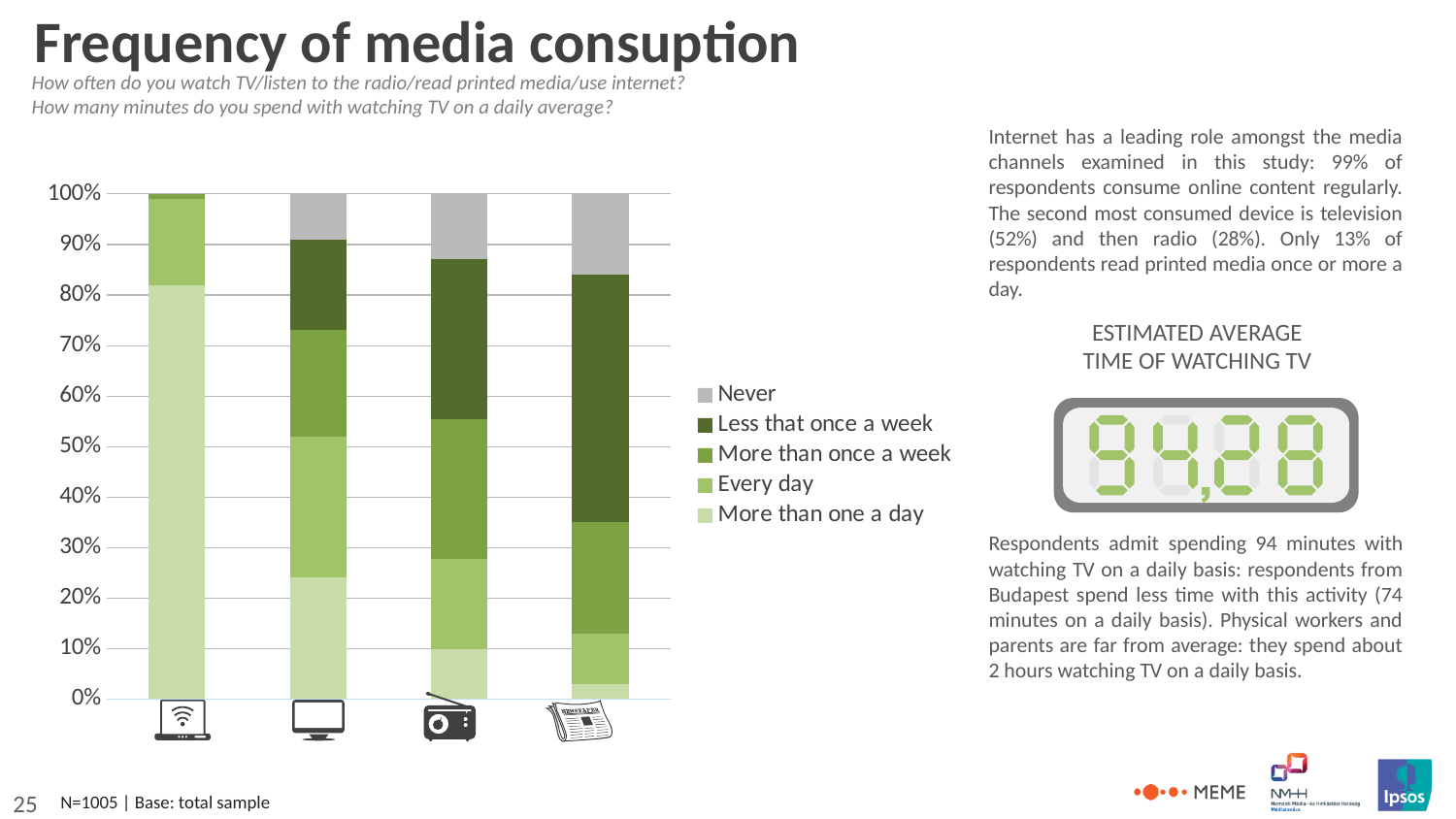
How many bars (media categories) are plotted in the chart? 4 What kind of chart is shown on the slide? Stacked bar chart Which entry is listed first in the chart's legend? Never Which bar has the larger 'Never' segment: the second bar (TV icon) or the fourth bar (newspaper icon)? The fourth bar (newspaper icon) What is the title of the slide containing the chart? Frequency of media consuption Is the 'Less that once a week' segment of the fourth bar (newspaper icon) greater or less than 40%? greater Is the 'More than one a day' segment of the second bar (TV icon) greater or less than 30%? less Which bar has the smallest 'More than one a day' segment? The fourth bar (newspaper icon) Is the 'More than one a day' segment of the third bar (radio icon) greater or less than 20%? less Which bar has the larger 'More than one a day' segment: the leftmost bar (internet icon) or the second bar (TV icon)? The leftmost bar (internet icon) How many series does the legend of the chart list? 5